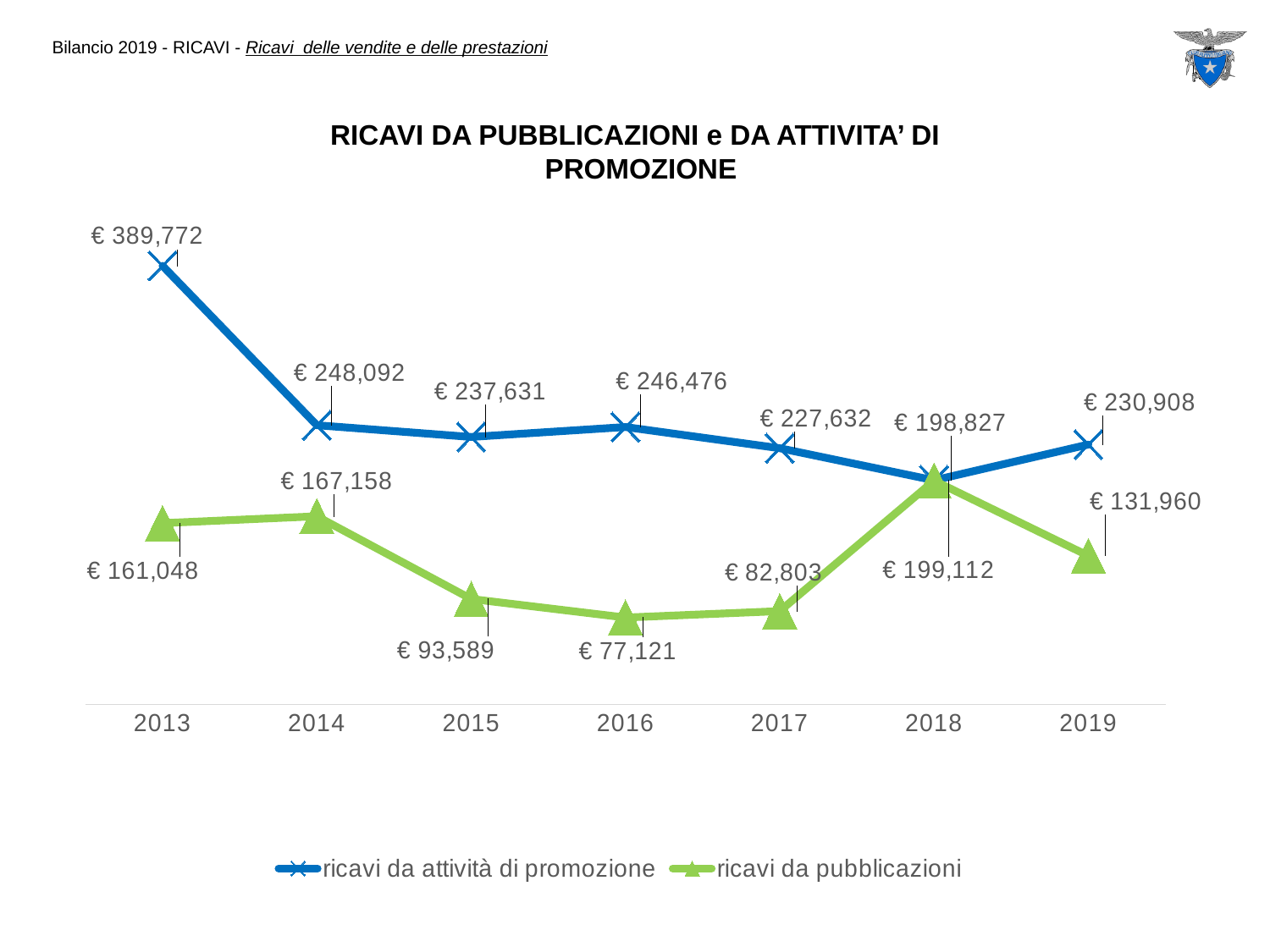
What is the value of ricavi da pubblicazioni in 2018? € 198,827 By how much did ricavi da attività di promozione fall from 2013 to 2014? € 141,680 Does ricavi da attività di promozione rise or fall from 2013 to 2018? fall How many series does the legend list? 2 What is the value of ricavi da pubblicazioni in 2016? € 77,121 What kind of chart is shown? line chart What is the value of ricavi da attività di promozione in 2013? € 389,772 How many years are shown on the x axis? 7 In which year is ricavi da pubblicazioni lowest? 2016 What is the difference between ricavi da pubblicazioni in 2018 and in 2017? € 116,024 In which year is ricavi da attività di promozione highest? 2013 In 2015, which series has the larger value? ricavi da attività di promozione